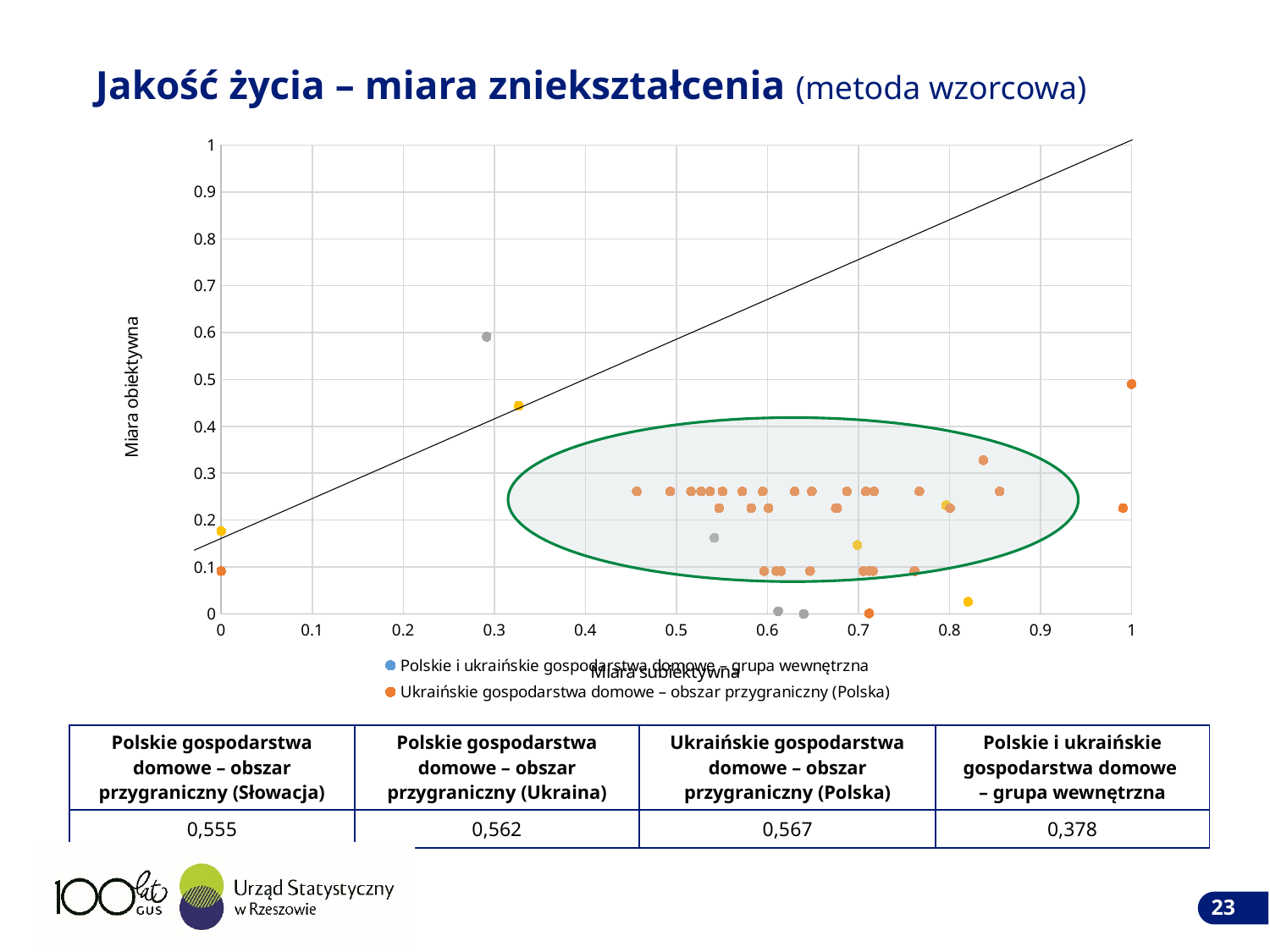
Are the y values of the points inside the green ellipse greater or less than 0.4? less How many series does the chart legend list? 2 Which point has the higher y value: the grey point near x = 0.3 or the yellow point near x = 0.33? the grey point near x = 0.3 What is the title of the vertical (y) axis of the chart? Miara obiektywna Is the y value of the orange point near x = 0.71 at the bottom of the chart greater or less than 0.1? less Does the straight diagonal line on the chart rise or fall as x increases? rise What kind of chart is shown on the slide? scatter chart Is the y value of the grey point located near x = 0.3 greater or less than 0.5? greater Which legend entry is shown with an orange marker? Ukraińskie gospodarstwa domowe – obszar przygraniczny (Polska)